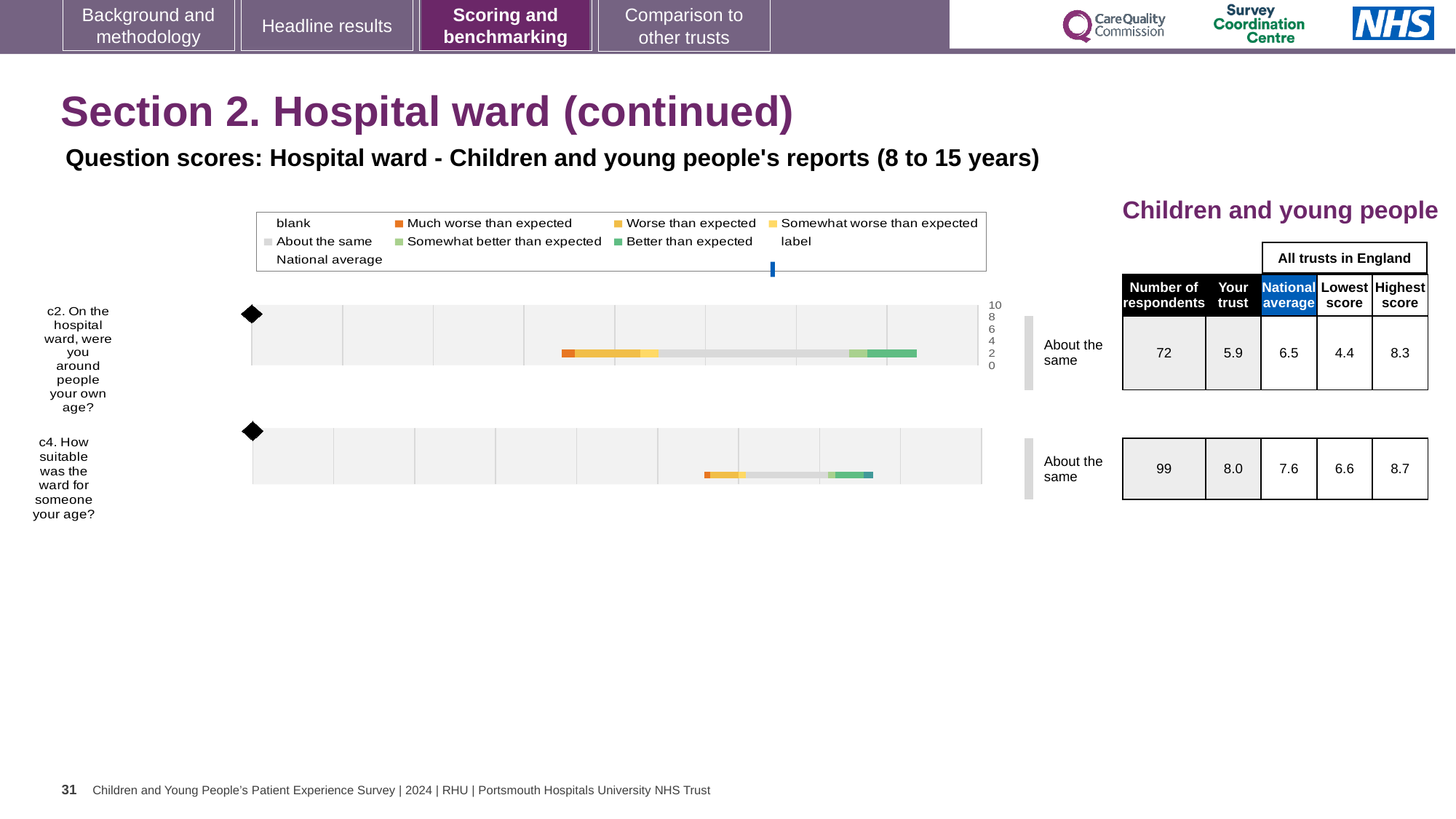
Which question has the higher 'Your trust' score, c2 or c4? c4 For question c2, is the 'Your trust' score higher or lower than the national average? lower What is the maximum value shown on the chart's score axis? 10 What is the national average score for question c4 (How suitable was the ward for someone your age?)? 7.6 What is the 'Your trust' score for question c2 (On the hospital ward, were you around people your own age?)? 5.9 What is the difference between the 'Your trust' scores for c4 and c2? 2.1 What is the difference between the highest and lowest scores across all trusts for question c2? 3.9 How many respondents answered question c2? 72 How many questions are plotted on the chart? 2 What is the highest score across all trusts in England for question c4? 8.7 What kind of chart is used to show the question scores for c2 and c4? bar chart What benchmark category is shown for question c4? About the same